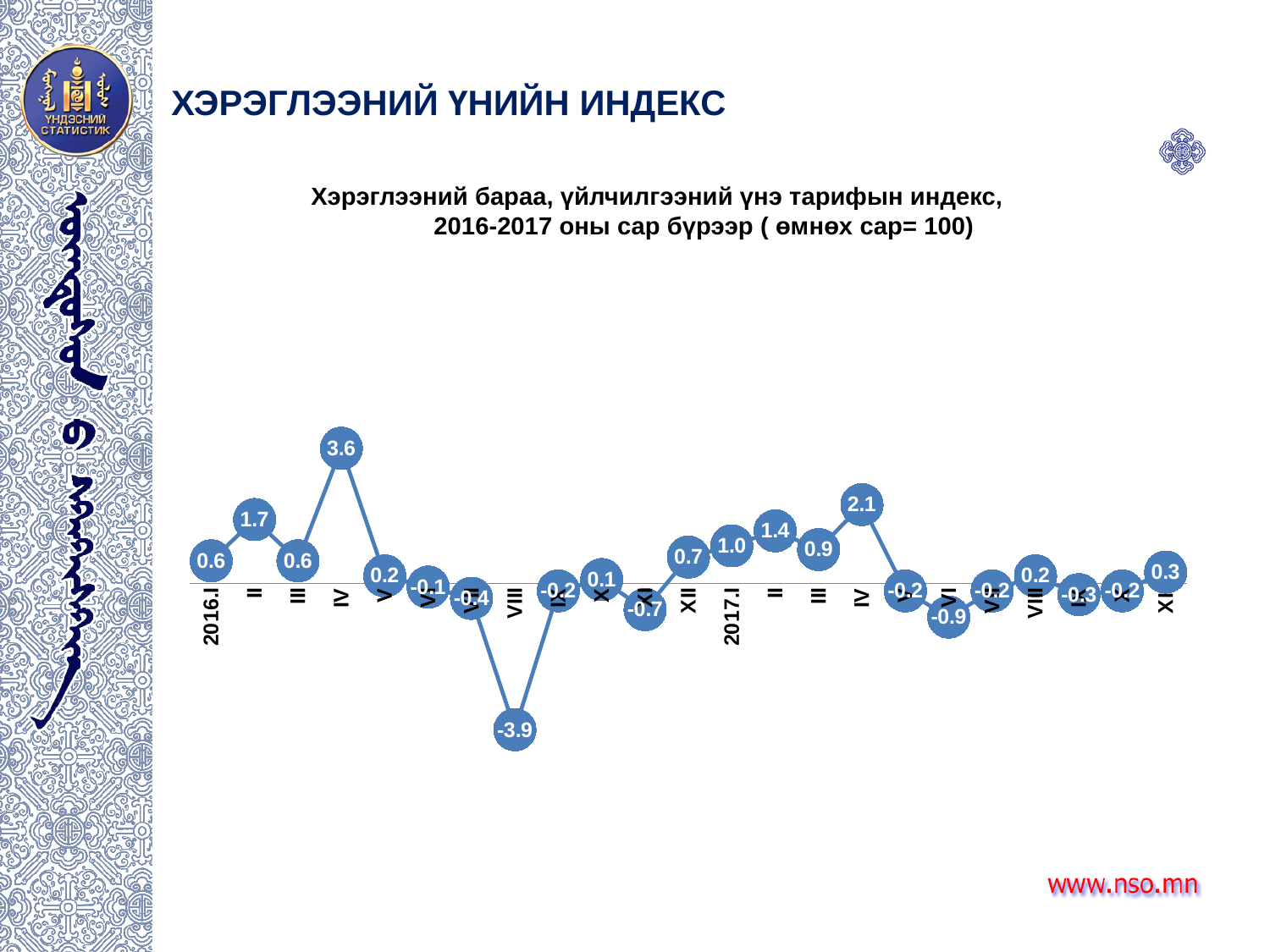
What is the value for the last month shown, 2017 XI? 0.3 What is the difference between the value for 2016 IV and the value for 2016 II? 1.9 Which month has the highest value in the chart? 2016 IV What kind of chart is shown on the slide? line chart What is the value for June (VI) of 2017? -0.9 Which month has the lowest value in the chart? 2016 VIII What is the value for February (II) of 2016? 1.7 Which is larger, the value for 2017 II or the value for 2017 III? 2017 II What is the value for November (XI) of 2016? -0.7 What is the value for April (IV) of 2017? 2.1 What is the value for 2017.I? 1.0 How many months (data points) are plotted in the chart? 23